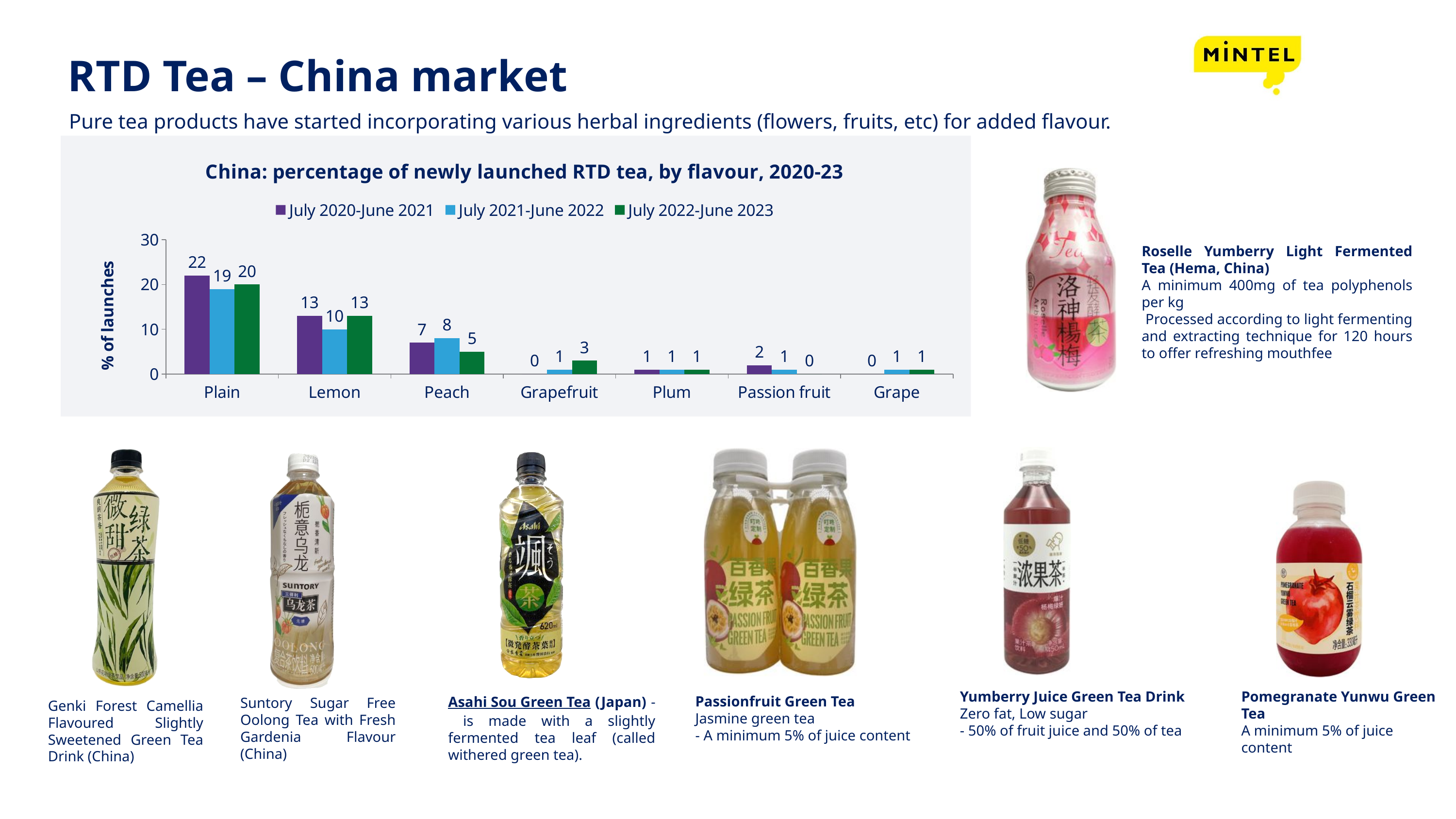
Which flavour has the highest percentage of launches in July 2022-June 2023? Plain How many flavour categories are shown on the x axis? 7 What is the value for Passion fruit in July 2020-June 2021? 2 How many series does the legend list? 3 What percentage of launches did Plain flavour account for in July 2020-June 2021? 22 Which is larger for Peach: the July 2021-June 2022 value or the July 2022-June 2023 value? July 2021-June 2022 What kind of chart is shown on the slide? Bar chart Did the value for Grapefruit rise or fall from July 2020-June 2021 to July 2022-June 2023? Rise What is the value for Grapefruit in July 2022-June 2023? 3 What is the value for Lemon in July 2021-June 2022? 10 What is the difference between the Plain values for July 2020-June 2021 and July 2021-June 2022? 3 What is the label on the y axis of the chart? % of launches